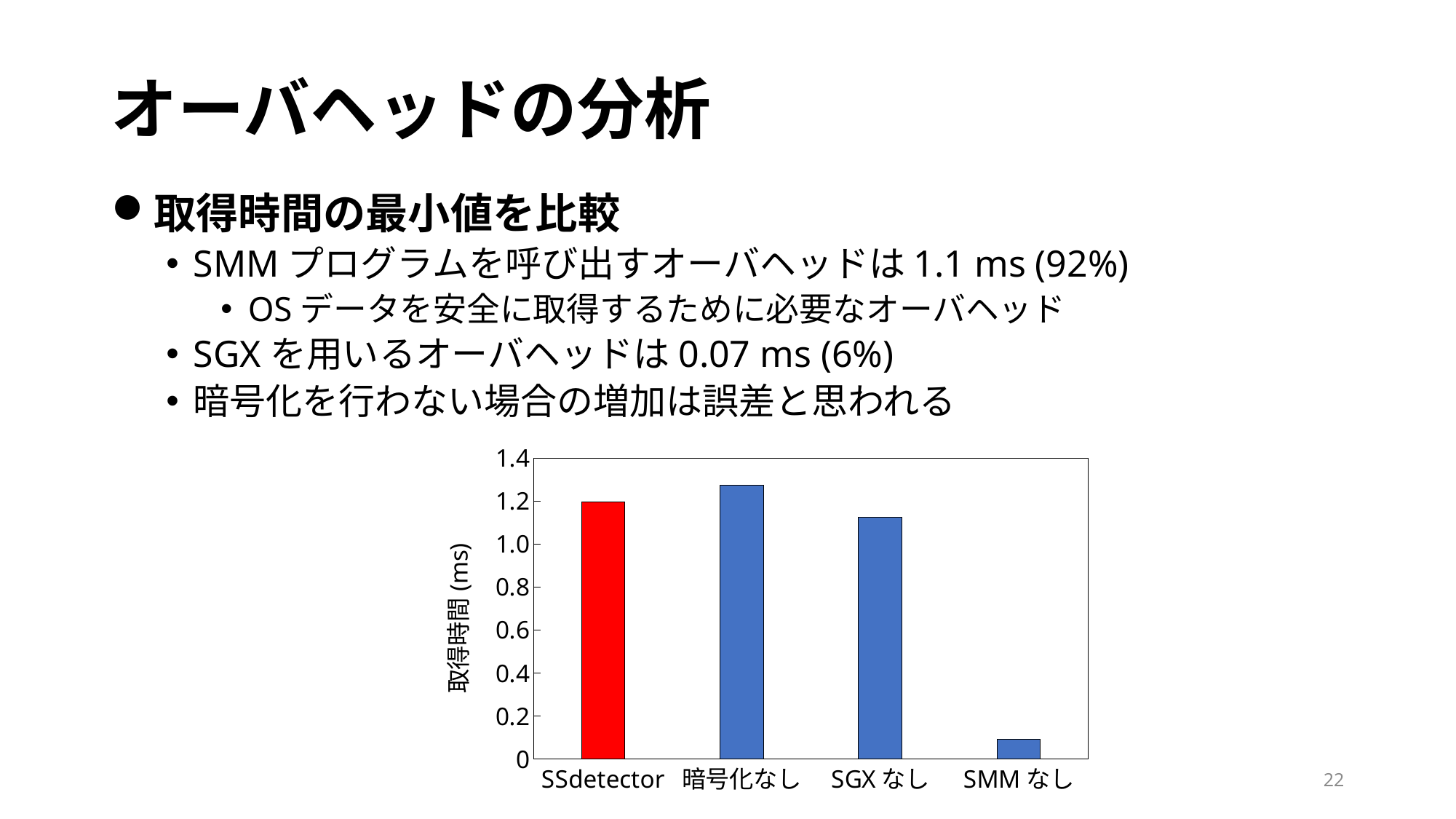
Is the value for SMM なし greater or less than 0.2? less Is the value for SSdetector greater or less than 1.0? greater What is the label of the y axis of the chart? 取得時間 (ms) Is the value for 暗号化なし greater or less than 1.2? greater How many categories are shown on the x axis of the chart? 4 Which category has the lowest 取得時間 in the chart? SMM なし Which has a larger 取得時間, SSdetector or SGX なし? SSdetector Which has a larger 取得時間, 暗号化なし or SSdetector? 暗号化なし Which bar in the chart is coloured red? SSdetector Which category has the highest 取得時間 in the chart? 暗号化なし What kind of chart is shown on the slide? bar chart